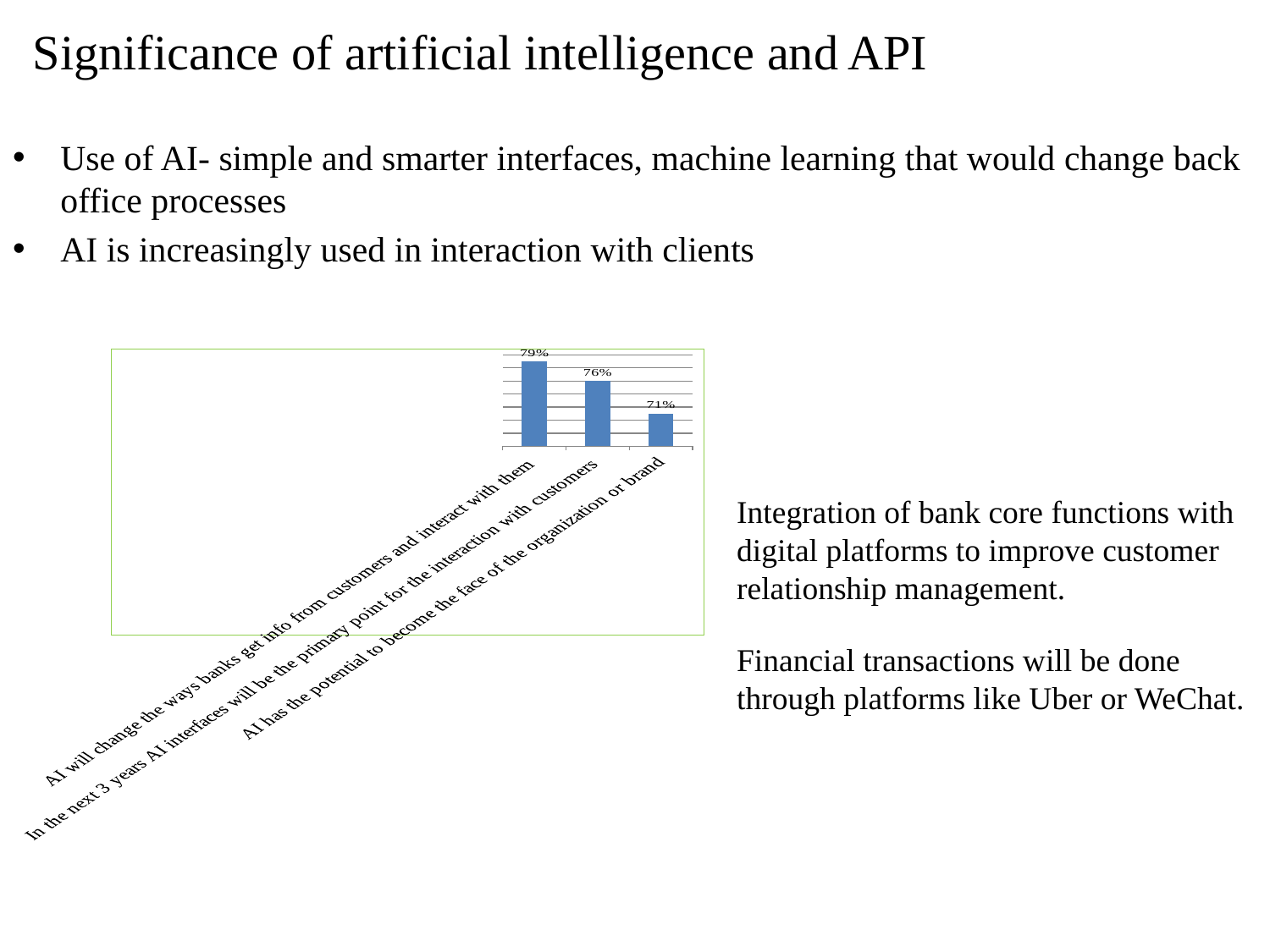
Which category has the lowest value in the chart? AI has the potential to become the face of the organization or brand What is the difference between the highest and lowest values in the chart? 8% How many categories are plotted in the chart? 3 What is the difference between the values for "AI will change the ways banks get info from customers and interact with them" and "In the next 3 years AI interfaces will be the primary point for the interaction with customers"? 3% What colour are the bars in the chart? Blue Which category has the highest value in the chart? AI will change the ways banks get info from customers and interact with them What value is shown for "In the next 3 years AI interfaces will be the primary point for the interaction with customers"? 76% Do the values rise or fall from left to right across the chart? Fall What value is shown for "AI will change the ways banks get info from customers and interact with them"? 79% Which is larger: the value for "In the next 3 years AI interfaces will be the primary point for the interaction with customers" or the value for "AI has the potential to become the face of the organization or brand"? In the next 3 years AI interfaces will be the primary point for the interaction with customers What value is shown for "AI has the potential to become the face of the organization or brand"? 71% What kind of chart is shown on the slide? Bar chart